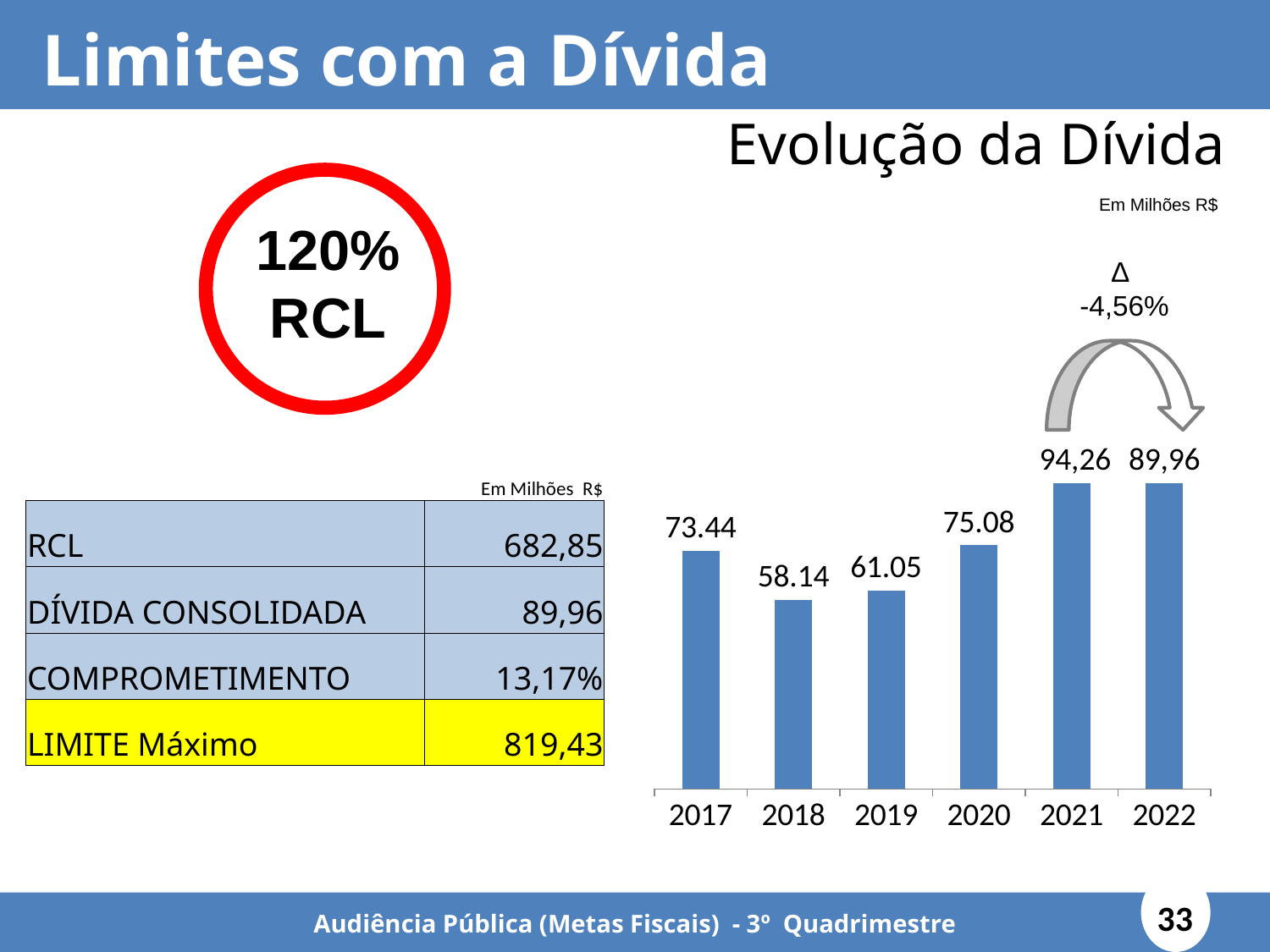
In the 'Evolução da Dívida' chart, what is the value for 2022? 89,96 In the 'Evolução da Dívida' chart, what is the value for 2020? 75.08 In the 'Evolução da Dívida' chart, what is the difference between the 2021 value and the 2022 value? 4,30 What percentage change (Δ) is annotated above the last two bars of the 'Evolução da Dívida' chart? -4,56% What kind of chart is 'Evolução da Dívida'? bar chart In the 'Evolução da Dívida' chart, which is larger, the value for 2018 or the value for 2019? 2019 How many years are shown on the x axis of the 'Evolução da Dívida' chart? 6 In the 'Evolução da Dívida' chart, what is the difference between the 2020 value and the 2017 value? 1.64 In the 'Evolução da Dívida' chart, which year has the highest value? 2021 In the 'Evolução da Dívida' chart, what is the value for 2017? 73.44 In the 'Evolução da Dívida' chart, do the values rise or fall from 2018 to 2021? rise In the 'Evolução da Dívida' chart, which year has the lowest value? 2018